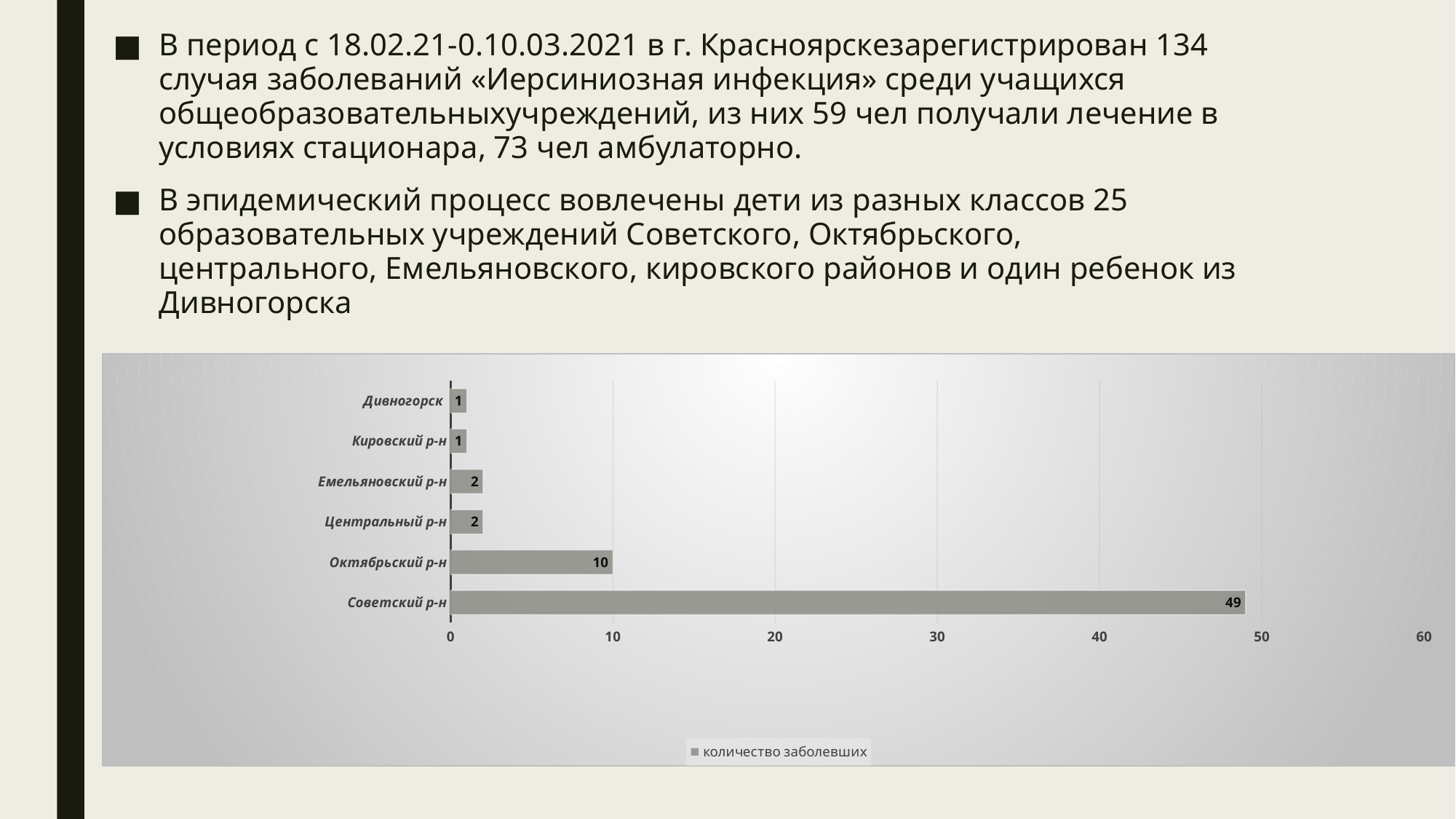
How many series does the legend list? 1 What is the value for Октябрьский р-н? 10 What kind of chart is shown on the slide? bar chart What is the difference between the values for Советский р-н and Октябрьский р-н? 39 What is the legend entry of the chart? количество заболевших What is the value for Дивногорск? 1 What is the value for Советский р-н? 49 How many categories are shown on the chart? 6 What is the value for Емельяновский р-н? 2 Which category has the highest value? Советский р-н Which is larger, the value for Октябрьский р-н or the value for Центральный р-н? Октябрьский р-н Is the value for Советский р-н greater or less than 40? greater